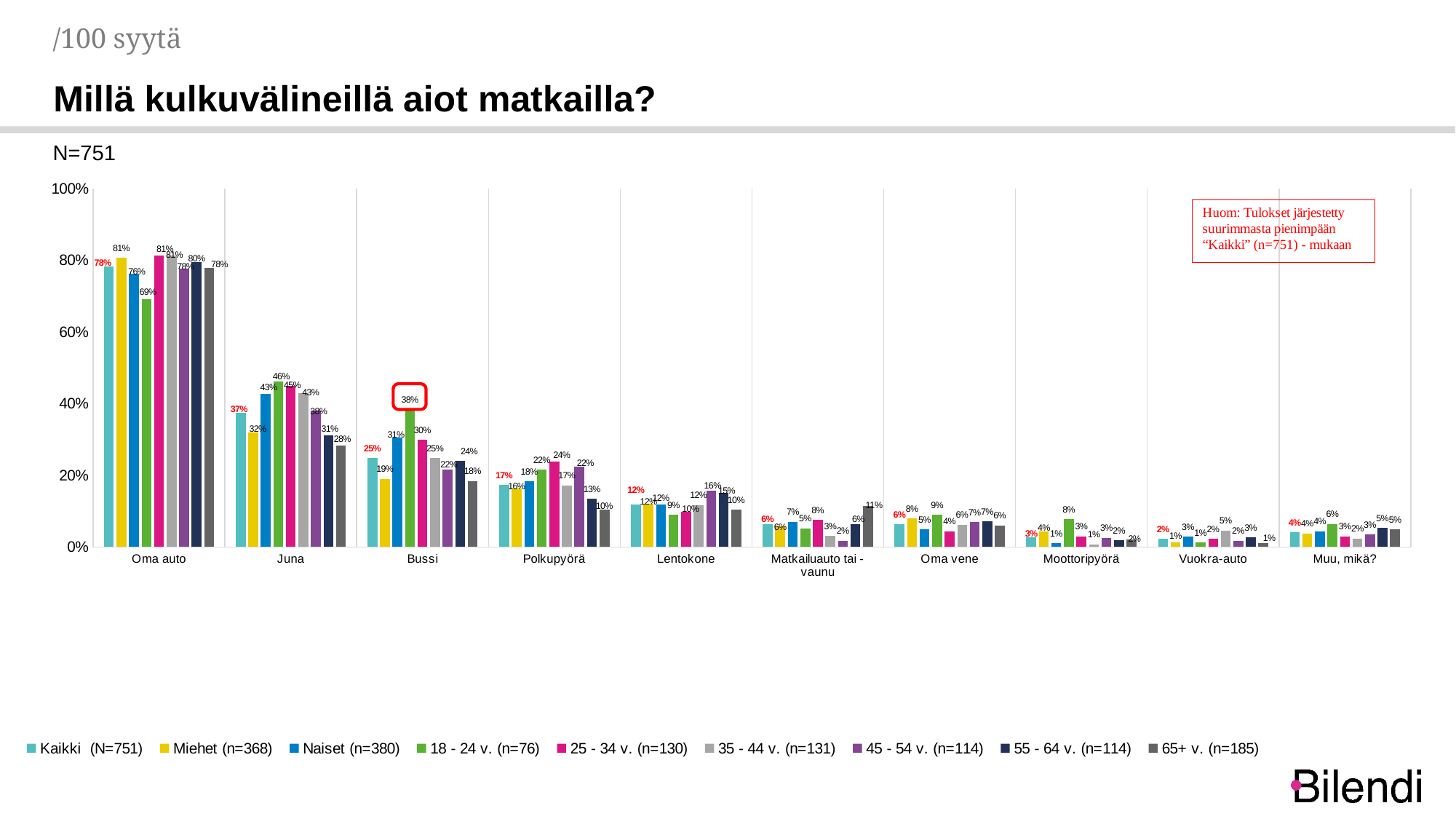
Which category has the lowest value for the Kaikki (N=751) series? Vuokra-auto What is the value for 65+ v. (n=185) for Matkailuauto tai -vaunu? 11% How many series does the legend list? 9 What kind of chart is shown on the slide? Bar chart Is the value for Naiset (n=380) for Oma auto greater or less than 60%? greater How many categories (modes of transport) are shown on the x axis? 10 For Juna, which is larger: the value for 18 - 24 v. (n=76) or the value for 65+ v. (n=185)? 18 - 24 v. (n=76) Do the Kaikki (N=751) values generally rise or fall from left to right along the x axis? Fall Which category has the highest value for the Kaikki (N=751) series? Oma auto What is the value for Kaikki (N=751) for Oma auto? 78% What is the value for 18 - 24 v. (n=76) for Bussi? 38% For Juna, what is the difference between the Naiset (n=380) value and the Miehet (n=368) value? 11 percentage points